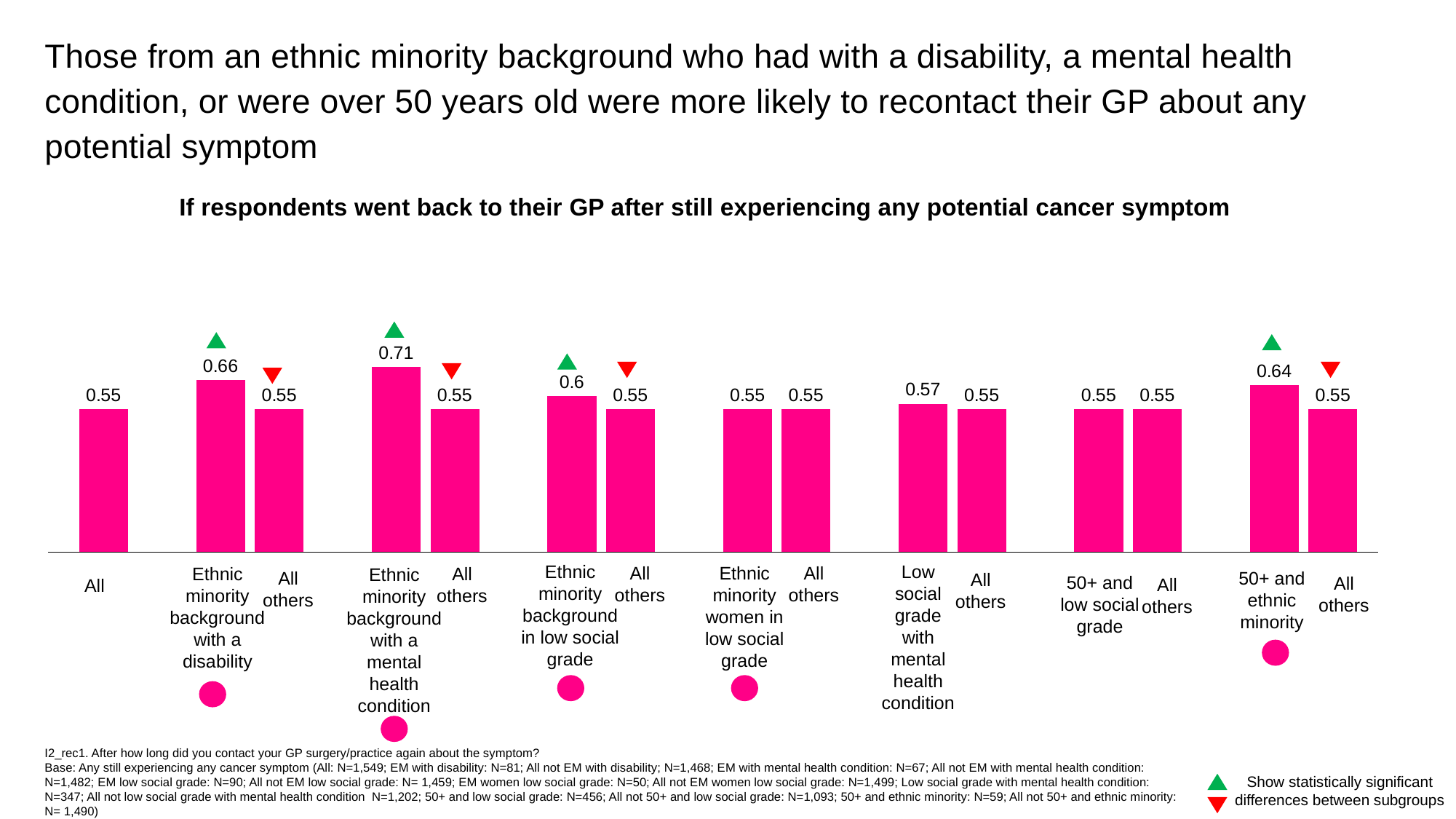
What is the value for 'Ethnic minority background with a disability'? 0.66 What is the value for the 'All' bar? 0.55 What is the value for 'Low social grade with mental health condition'? 0.57 What is the value for 'Ethnic minority background with a mental health condition'? 0.71 What kind of chart is shown? Bar chart What is the title of the chart? If respondents went back to their GP after still experiencing any potential cancer symptom What is the difference between 'Ethnic minority background with a mental health condition' and the 'All' bar? 0.16 What is the difference between 'Ethnic minority background with a disability' and '50+ and ethnic minority'? 0.02 Which category has the highest value? Ethnic minority background with a mental health condition How many bars are plotted in the chart? 15 What is the value for '50+ and ethnic minority'? 0.64 Which is larger: 'Ethnic minority background in low social grade' or '50+ and ethnic minority'? 50+ and ethnic minority